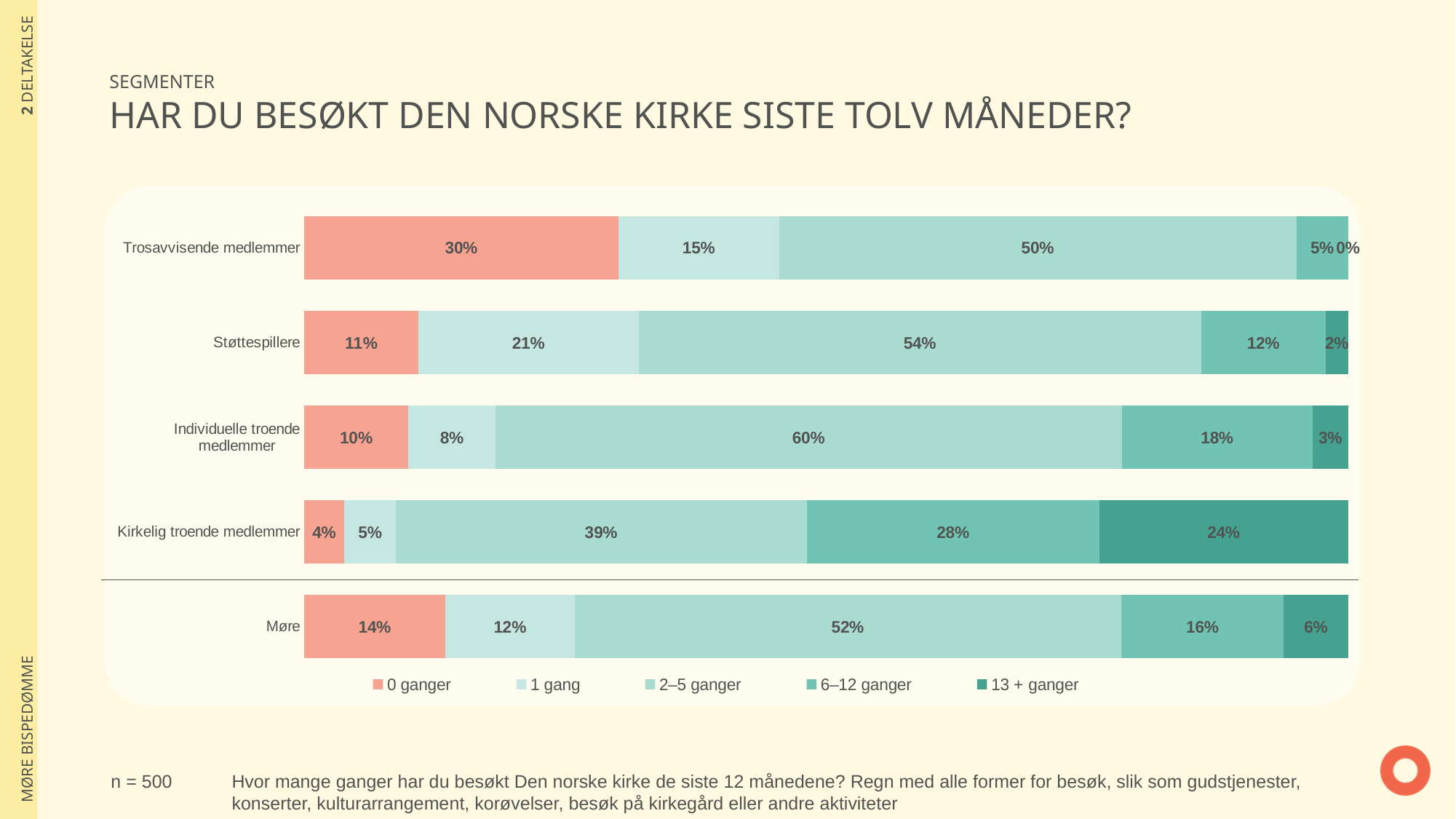
What is the value for 2–5 ganger among Individuelle troende medlemmer? 60% What is the difference between the 2–5 ganger values for Støttespillere and Kirkelig troende medlemmer? 15% How many series does the legend list? 5 Which category has the lowest value for 13 + ganger? Trosavvisende medlemmer Which legend entry is shown in the salmon/red colour? 0 ganger Which category has the highest value for 0 ganger? Trosavvisende medlemmer What share of Møre respondents answered 0 ganger? 14% What kind of chart is shown on the slide? Stacked bar chart What percentage of Kirkelig troende medlemmer visited the church 13 + ganger? 24% What is the combined value of 6–12 ganger and 13 + ganger for Kirkelig troende medlemmer? 52% Which is larger: the 6–12 ganger value for Støttespillere or for Møre? Møre How many categories (bars) are shown in the chart? 5